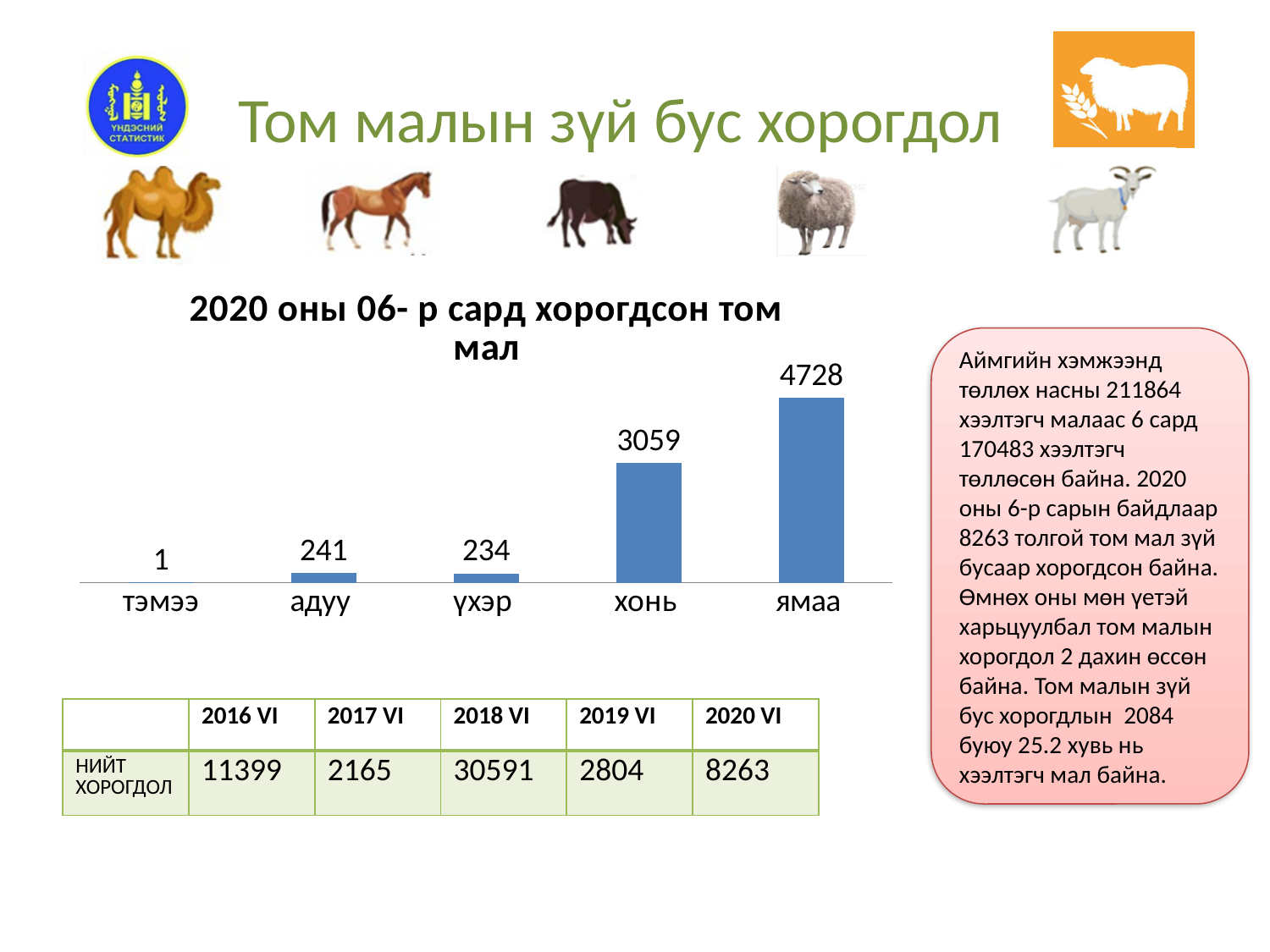
What is the value for адуу in the chart? 241 What is the difference between the values for адуу and үхэр? 7 Which category has the lowest value in the chart? тэмээ What is the value for ямаа in the chart? 4728 How many categories are shown in the chart? 5 Which is larger, the value for хонь or the value for адуу? хонь What is the value for үхэр in the chart? 234 What is the value for хонь in the chart? 3059 What is the difference between the values for ямаа and хонь? 1669 What kind of chart is shown on the slide? bar chart What is the value for тэмээ in the chart? 1 Which category has the highest value in the chart? ямаа